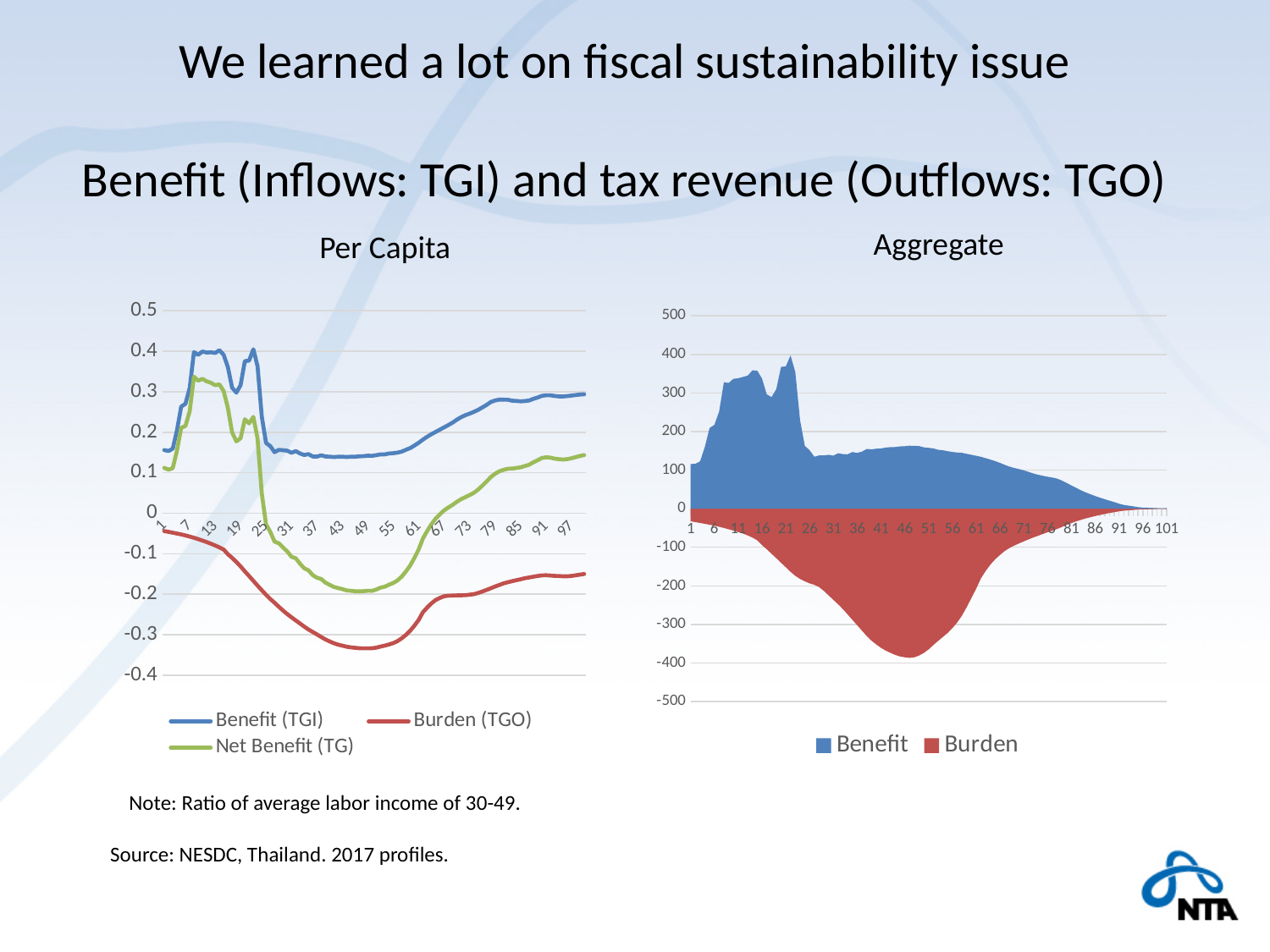
How many series does the legend of the Per Capita chart list? 3 In the Aggregate chart, what colour represents the Burden series? red In the Per Capita chart, is the Benefit (TGI) value at age 13 greater or less than 0.3? greater In the Per Capita chart, is the Burden (TGO) value at age 49 greater or less than -0.3? less In the Per Capita chart, does the Burden (TGO) line rise or fall between age 1 and age 49? fall In the Aggregate chart, is the Burden value at 46 greater or less than -300? less What kind of chart is the Aggregate chart on the right? area chart What kind of chart is the Per Capita chart on the left? line chart In the Per Capita chart, does the Benefit (TGI) line rise or fall between age 61 and age 97? rise How many series does the legend of the Aggregate chart list? 2